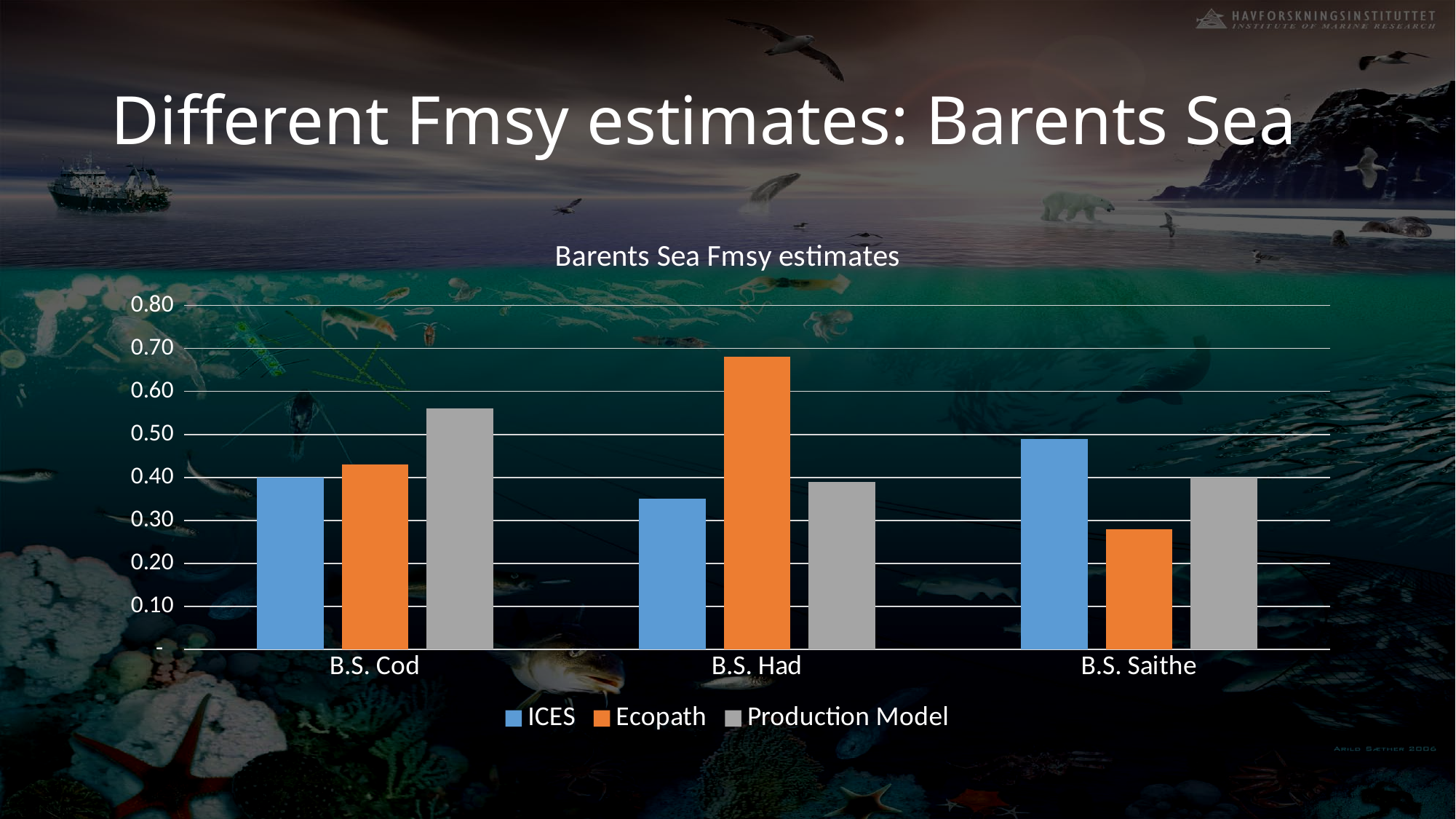
Which category has the highest ICES value? B.S. Saithe Which category has the highest Ecopath value? B.S. Had Which colour represents the Ecopath series in the legend? Orange Is the Ecopath value for B.S. Had greater or less than 0.60? greater How many series does the legend list? 3 What type of chart is shown on the slide? Bar chart Which category has the lowest Ecopath value? B.S. Saithe For B.S. Had, which is larger: the Ecopath value or the Production Model value? Ecopath What is the title of the chart? Barents Sea Fmsy estimates How many categories are shown on the x axis? 3 Is the Production Model value for B.S. Cod greater or less than 0.50? greater Is the Ecopath value for B.S. Saithe greater or less than 0.30? less